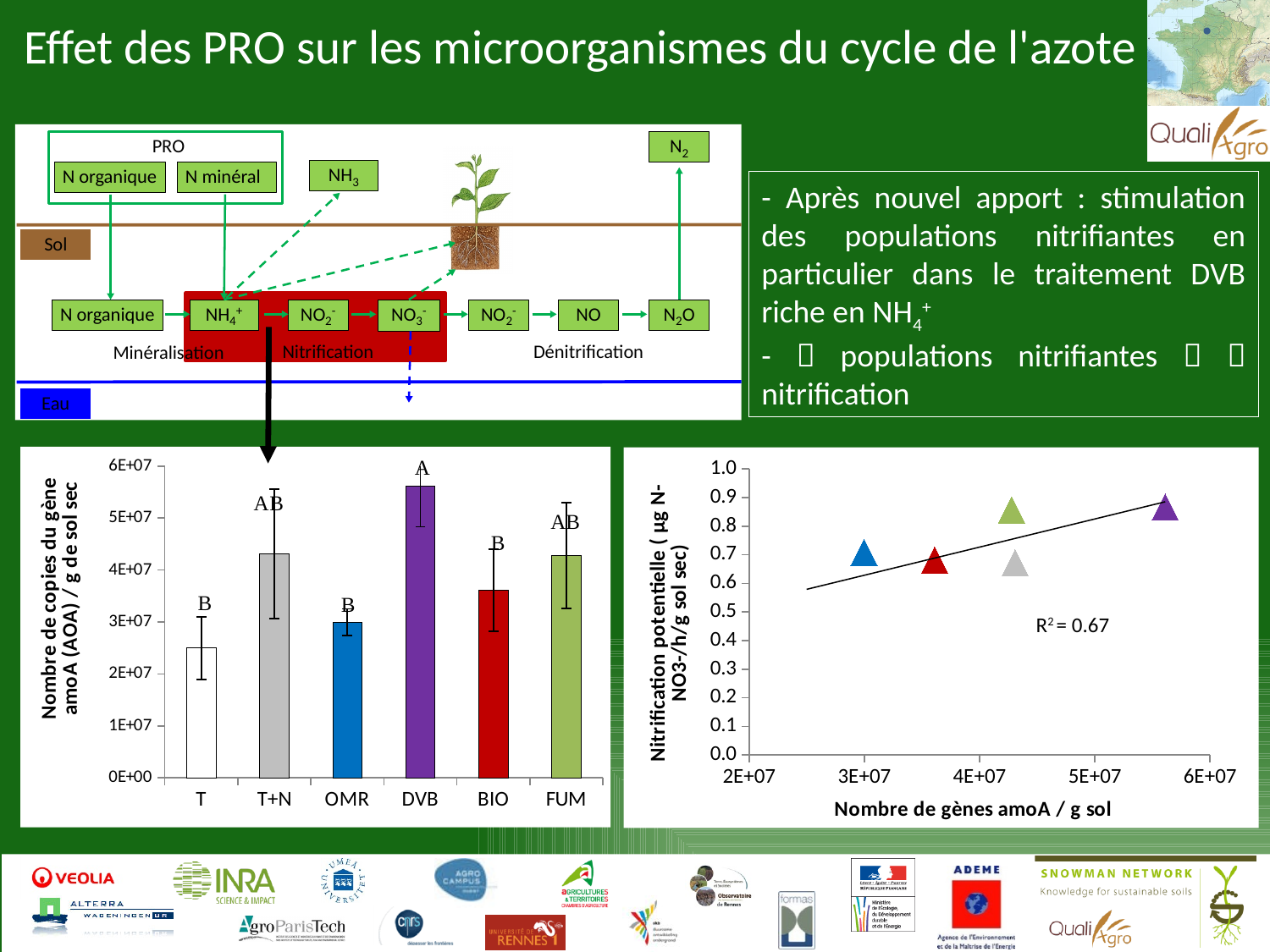
In the right scatter plot, what R² value is printed on the chart? R² = 0.67 What kind of chart is the chart on the right of the slide? scatter plot In the left bar chart, is the value for DVB greater or less than 5E+07? greater In the left bar chart, which treatment has the highest number of amoA gene copies? DVB What kind of chart is the chart on the left of the slide? bar chart In the left bar chart, which is larger, the value for T+N or the value for OMR? T+N In the left bar chart, which treatment has the lowest number of amoA gene copies? T In the left bar chart, how many treatment categories are shown on the x axis? 6 In the left bar chart, is the value for FUM greater or less than 4E+07? greater In the right scatter plot, does potential nitrification rise or fall as the number of amoA genes increases along the x axis? rise In the left bar chart, is the value for T greater or less than 3E+07? less